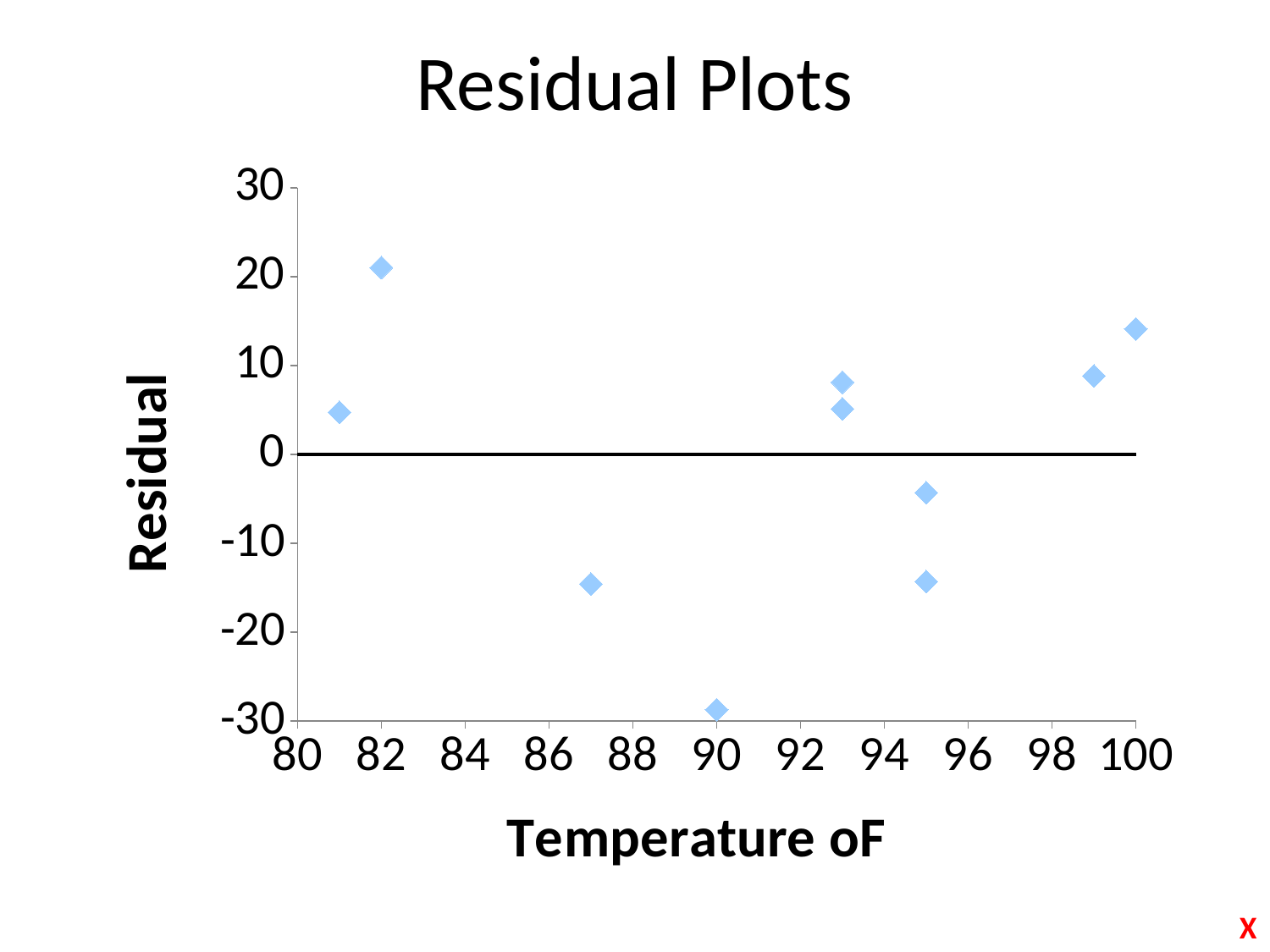
Which has the larger residual: the point at temperature 87 or the point at temperature 90? 87 At which temperature is the lowest residual plotted? 90 What is the label of the x axis? Temperature oF Is the residual at temperature 100 greater or less than 10? greater Is the residual at temperature 87 greater or less than -10? less At which temperature is the highest residual plotted? 82 Is the residual at temperature 90 greater or less than -20? less How many data points are plotted on the chart? 10 Which has the larger residual: the point at temperature 82 or the point at temperature 100? 82 What kind of chart is shown on the slide? scatter plot What is the title of the chart? Residual Plots